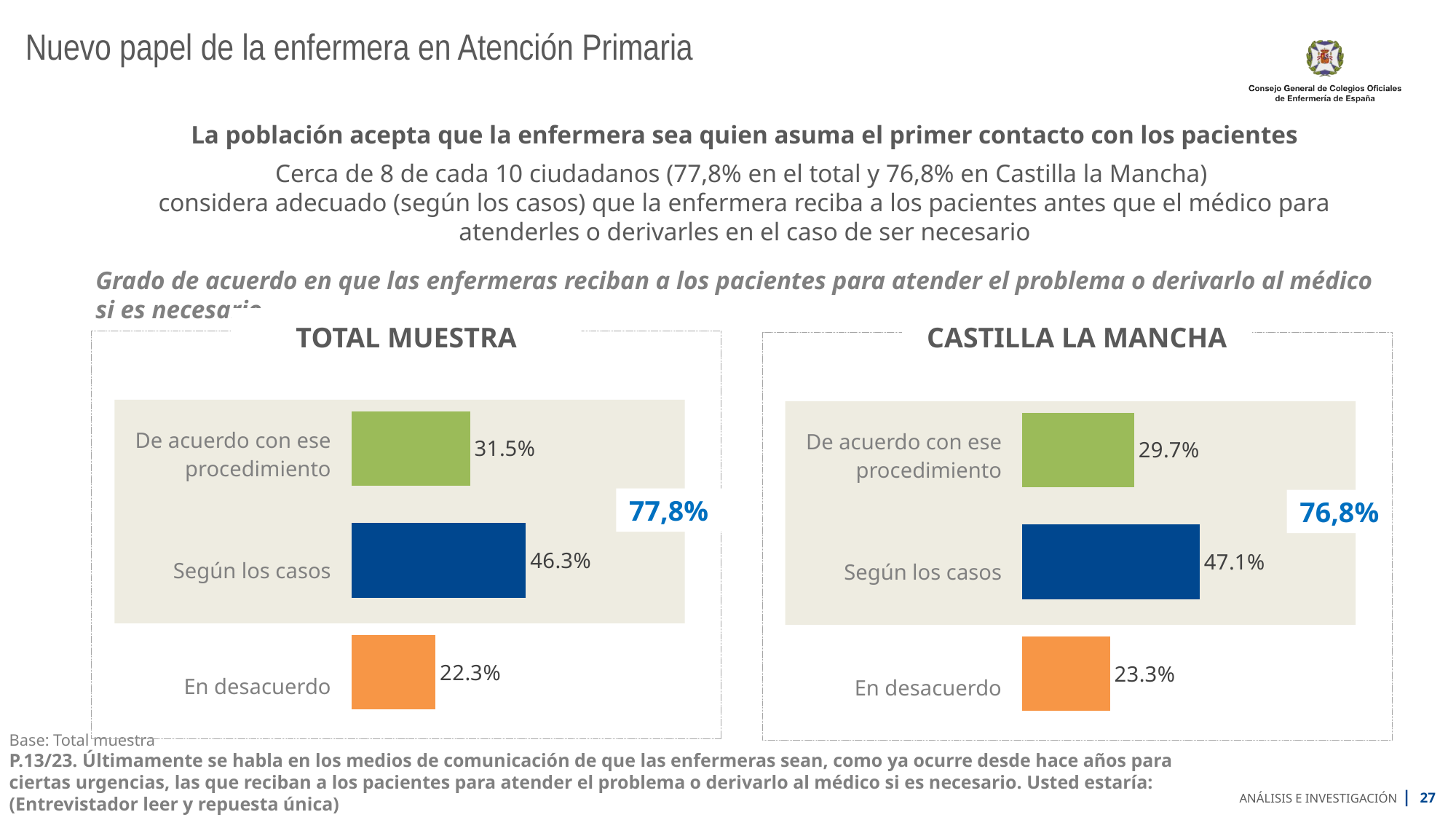
In the CASTILLA LA MANCHA chart, what is the value for "De acuerdo con ese procedimiento"? 29.7% In the CASTILLA LA MANCHA chart, what colour is the bar for "En desacuerdo"? Orange What type of chart is the TOTAL MUESTRA chart? Bar chart In the CASTILLA LA MANCHA chart, what is the value for "En desacuerdo"? 23.3% In the CASTILLA LA MANCHA chart, which category has the lowest value? En desacuerdo In the CASTILLA LA MANCHA chart, what is the difference between "De acuerdo con ese procedimiento" and "En desacuerdo"? 6.4% In the TOTAL MUESTRA chart, what is the value for "Según los casos"? 46.3% In the TOTAL MUESTRA chart, what is the difference between "Según los casos" and "De acuerdo con ese procedimiento"? 14.8% How many categories are shown in the CASTILLA LA MANCHA chart? 3 Which is larger: "Según los casos" in the TOTAL MUESTRA chart or "Según los casos" in the CASTILLA LA MANCHA chart? CASTILLA LA MANCHA In the TOTAL MUESTRA chart, which category has the highest value? Según los casos In the TOTAL MUESTRA chart, what combined percentage is highlighted in blue for the first two categories? 77,8%